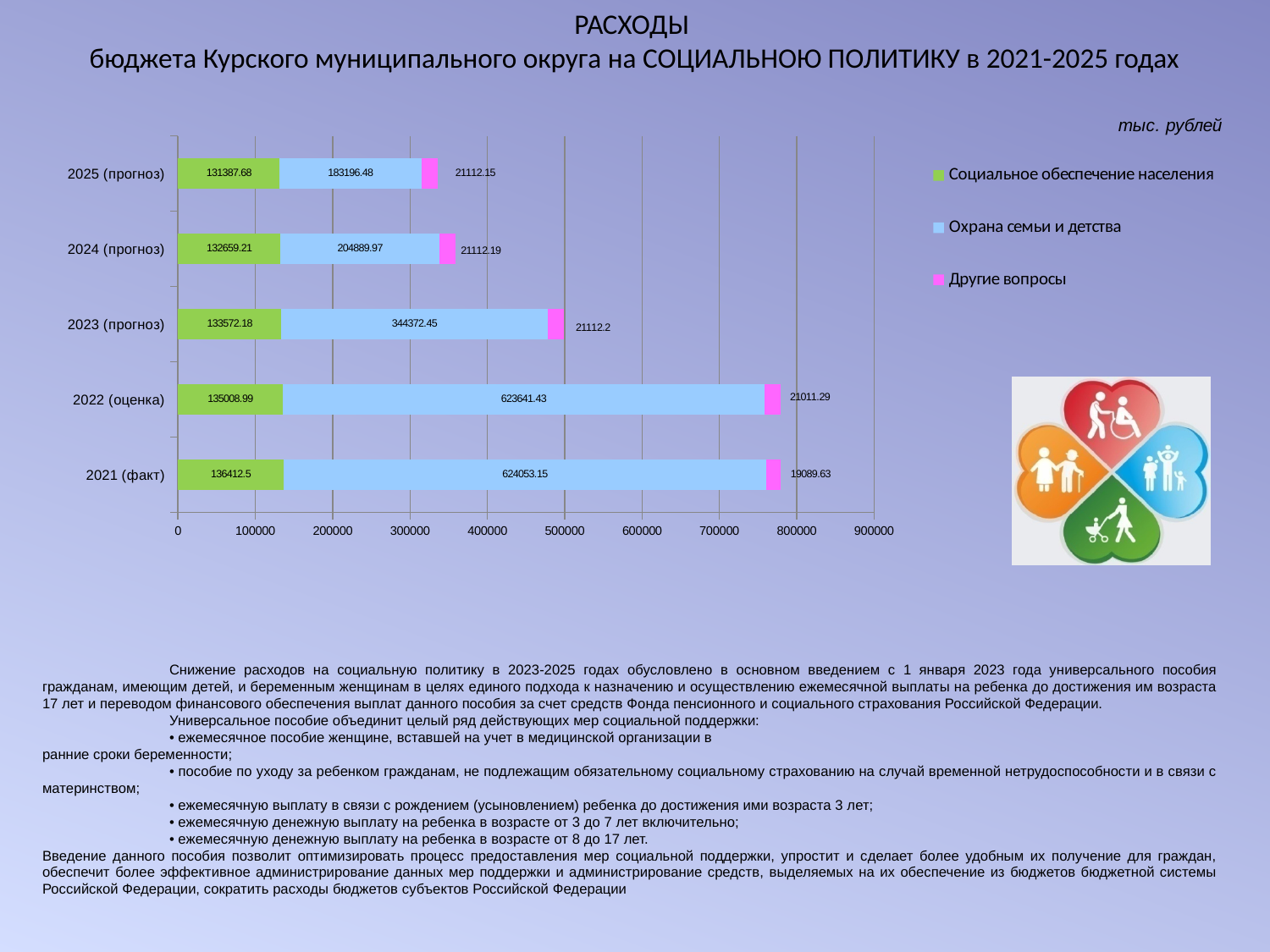
What is the total of the stacked bar for 2025 (прогноз)? 335696.31 Which is larger: the Социальное обеспечение населения value for 2021 (факт) or for 2025 (прогноз)? 2021 (факт) What unit is indicated for the chart values? тыс. рублей In which year is the value for Охрана семьи и детства the lowest? 2025 (прогноз) What kind of chart is shown on the slide? Stacked bar chart In which year is the value for Охрана семьи и детства the highest? 2021 (факт) How many years (categories) are shown on the chart? 5 What value is shown for Социальное обеспечение населения in 2021 (факт)? 136412.5 What is the difference between the Охрана семьи и детства values for 2022 (оценка) and 2023 (прогноз)? 279268.98 How many series does the legend list? 3 What value is shown for Другие вопросы in 2022 (оценка)? 21011.29 What value is shown for Охрана семьи и детства in 2023 (прогноз)? 344372.45